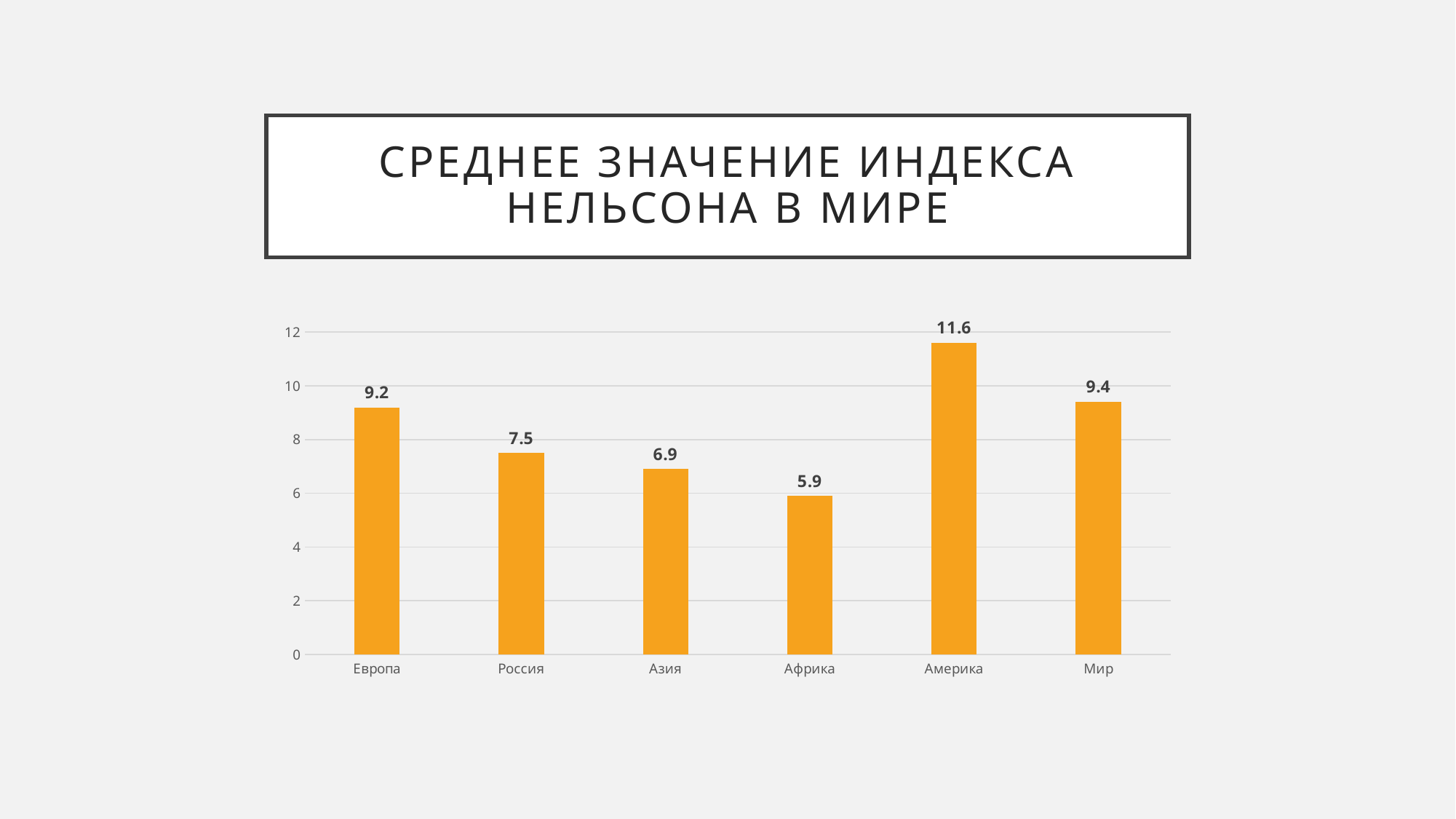
Which category has the highest value? Америка What is the difference between the values for Америка and Африка? 5.7 Which category has the lowest value? Африка What is the value for Россия? 7.5 What kind of chart is shown on the slide? Bar chart What is the value for Мир? 9.4 What is the value for Африка? 5.9 How many categories are shown on the chart? 6 Which is larger, the value for Россия or the value for Азия? Россия What is the value for Европа? 9.2 What is the title of the slide? Среднее значение индекса Нельсона в мире What is the difference between the values for Мир and Азия? 2.5